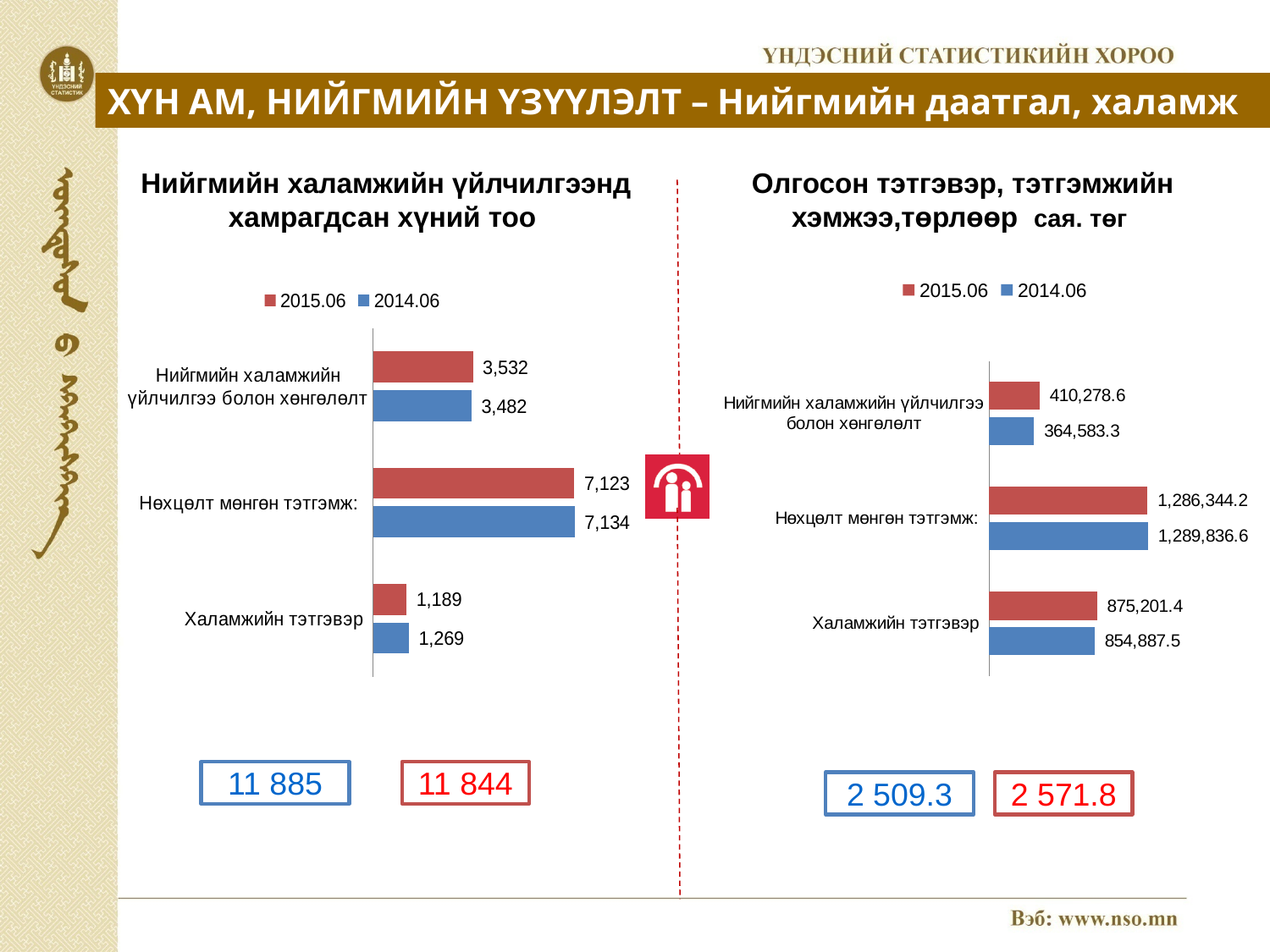
In the left chart (Нийгмийн халамжийн үйлчилгээнд хамрагдсан хүний тоо), which category has the highest 2015.06 value? Нөхцөлт мөнгөн тэтгэмж In the right chart (Олгосон тэтгэвэр, тэтгэмжийн хэмжээ, төрлөөр), which category has the highest 2014.06 value? Нөхцөлт мөнгөн тэтгэмж In the right chart (Олгосон тэтгэвэр, тэтгэмжийн хэмжээ, төрлөөр), what is the 2014.06 value for Халамжийн тэтгэвэр? 854,887.5 In the left chart (Нийгмийн халамжийн үйлчилгээнд хамрагдсан хүний тоо), what is the 2014.06 value for Халамжийн тэтгэвэр? 1,269 What type of chart is the left chart (Нийгмийн халамжийн үйлчилгээнд хамрагдсан хүний тоо)? bar chart In the left chart (Нийгмийн халамжийн үйлчилгээнд хамрагдсан хүний тоо), how many series does the legend list? 2 In the right chart (Олгосон тэтгэвэр, тэтгэмжийн хэмжээ, төрлөөр), how many categories are shown? 3 In the left chart (Нийгмийн халамжийн үйлчилгээнд хамрагдсан хүний тоо), what is the 2015.06 value for Нөхцөлт мөнгөн тэтгэмж? 7,123 In the right chart (Олгосон тэтгэвэр, тэтгэмжийн хэмжээ, төрлөөр), is the 2015.06 value for Халамжийн тэтгэвэр larger or smaller than the 2014.06 value? larger In the left chart (Нийгмийн халамжийн үйлчилгээнд хамрагдсан хүний тоо), which category has the lowest 2014.06 value? Халамжийн тэтгэвэр In the left chart (Нийгмийн халамжийн үйлчилгээнд хамрагдсан хүний тоо), what is the difference between the 2015.06 and 2014.06 values for Нийгмийн халамжийн үйлчилгээ болон хөнгөлөлт? 50 In the right chart (Олгосон тэтгэвэр, тэтгэмжийн хэмжээ, төрлөөр), what is the 2015.06 value for Нийгмийн халамжийн үйлчилгээ болон хөнгөлөлт? 410,278.6